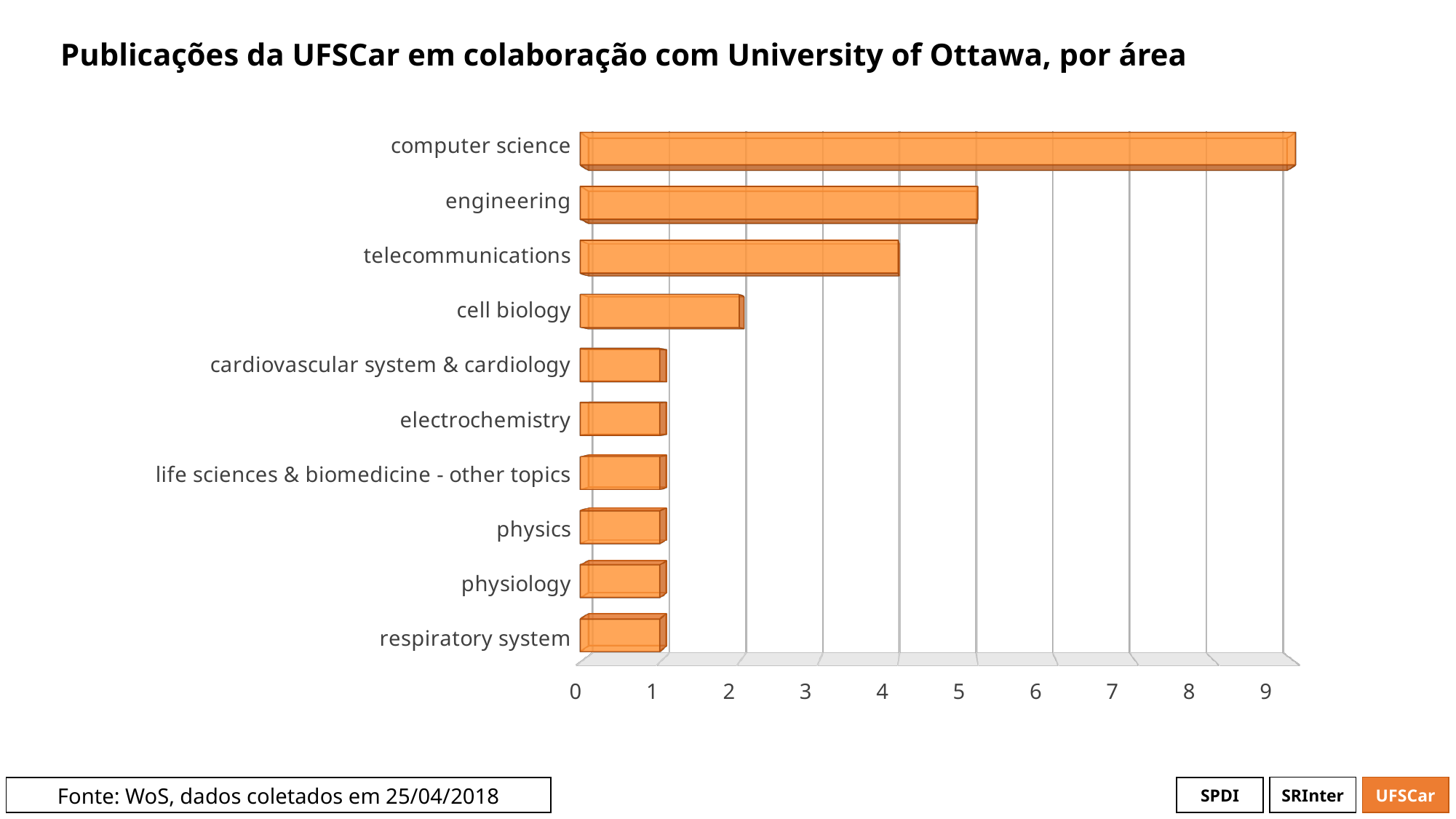
Is the value for computer science greater or less than 8? greater What is the title of the chart? Publicações da UFSCar em colaboração com University of Ottawa, por área Which area has the highest number of publications? computer science How many areas (categories) are shown in the chart? 10 Is the value for physics greater or less than 2? less What kind of chart is shown on the slide? bar chart Is the value for cell biology greater or less than 3? less Which has more publications, engineering or telecommunications? engineering Which has more publications, cell biology or electrochemistry? cell biology